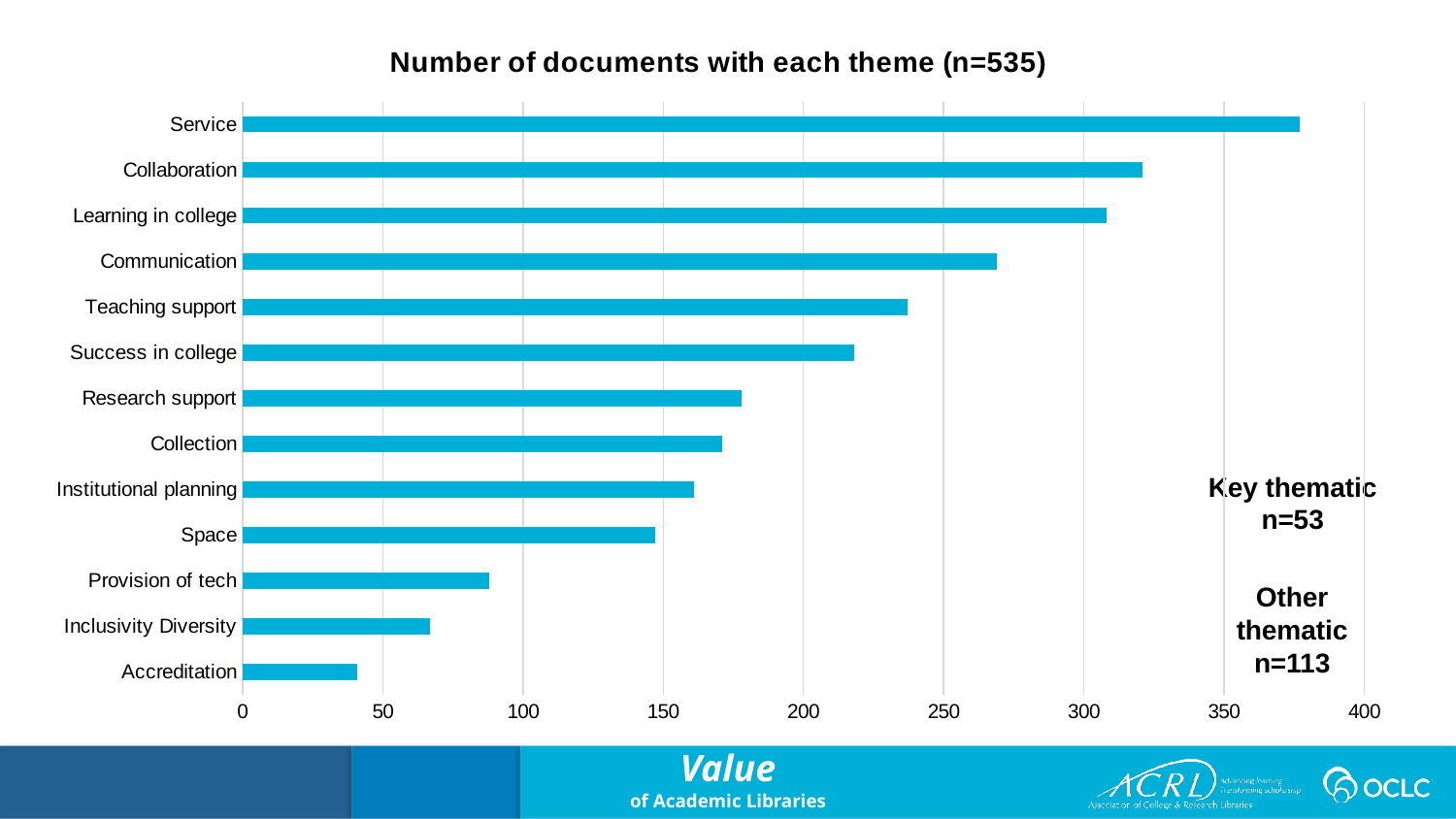
Is the value for Service greater or less than 350? greater Is the value for Provision of tech greater or less than 100? less Which has more documents, Provision of tech or Inclusivity Diversity? Provision of tech Which has more documents, Communication or Teaching support? Communication Which theme has the lowest number of documents? Accreditation What type of chart is shown on the slide? bar chart Which theme has the highest number of documents? Service How many themes (categories) are plotted in the chart? 13 Is the value for Collaboration greater or less than 300? greater What is the title of the chart? Number of documents with each theme (n=535)